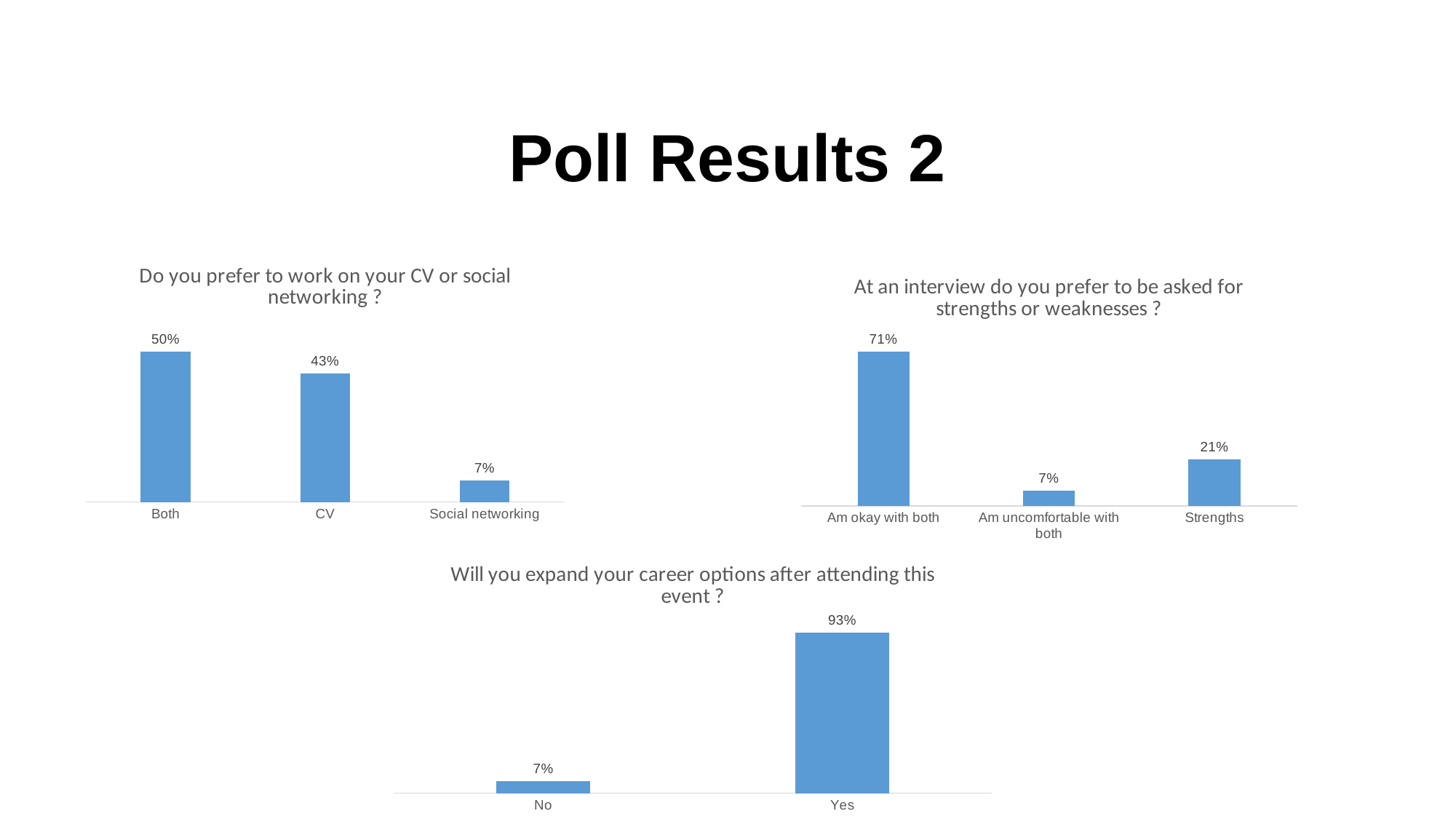
In the chart titled "Do you prefer to work on your CV or social networking ?", what is the difference between the values for Both and Social networking? 43% In the chart titled "Do you prefer to work on your CV or social networking ?", which category has the highest value? Both In the chart titled "Will you expand your career options after attending this event ?", what is the difference between the values for Yes and No? 86% In the chart titled "Will you expand your career options after attending this event ?", how many categories are shown? 2 In the chart titled "At an interview do you prefer to be asked for strengths or weaknesses ?", what is the difference between the values for Am okay with both and Strengths? 50% In the chart titled "Will you expand your career options after attending this event ?", what is the value for Yes? 93% What kind of chart is the chart titled "Will you expand your career options after attending this event ?"? Bar chart In the chart titled "At an interview do you prefer to be asked for strengths or weaknesses ?", what is the value for Strengths? 21% In the chart titled "At an interview do you prefer to be asked for strengths or weaknesses ?", which is larger, the value for Strengths or the value for Am uncomfortable with both? Strengths In the chart titled "Do you prefer to work on your CV or social networking ?", what is the value for CV? 43% In the chart titled "At an interview do you prefer to be asked for strengths or weaknesses ?", which category has the lowest value? Am uncomfortable with both In the chart titled "Do you prefer to work on your CV or social networking ?", how many categories are shown? 3